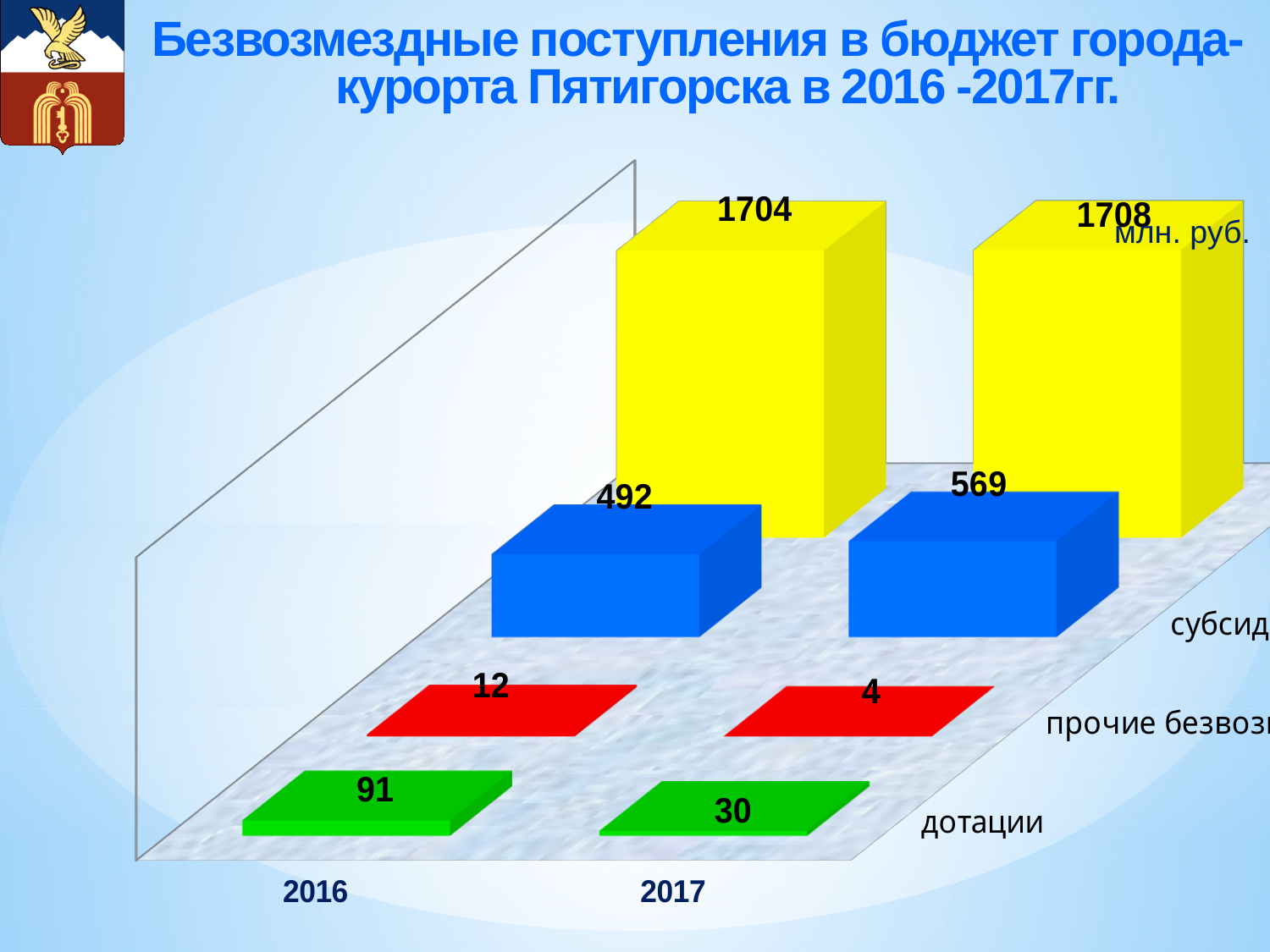
What value is labelled on the yellow bar for 2016? 1704 What value is labelled on the yellow bar for 2017? 1708 Which year has the larger value for дотации, 2016 or 2017? 2016 What is the value for дотации in 2017? 30 By how much did дотации decrease from 2016 to 2017? 61 Which bar has the highest value on the chart? The yellow bar for 2017 (1708) Which bar has the lowest value on the chart? The red bar for 2017 (4) What is the difference between the blue bar values for 2017 and 2016? 77 What value is labelled on the blue bar for 2017? 569 What is the value for дотации in 2016? 91 What value is labelled on the red bar for 2016? 12 What kind of chart is shown on the slide? Bar chart